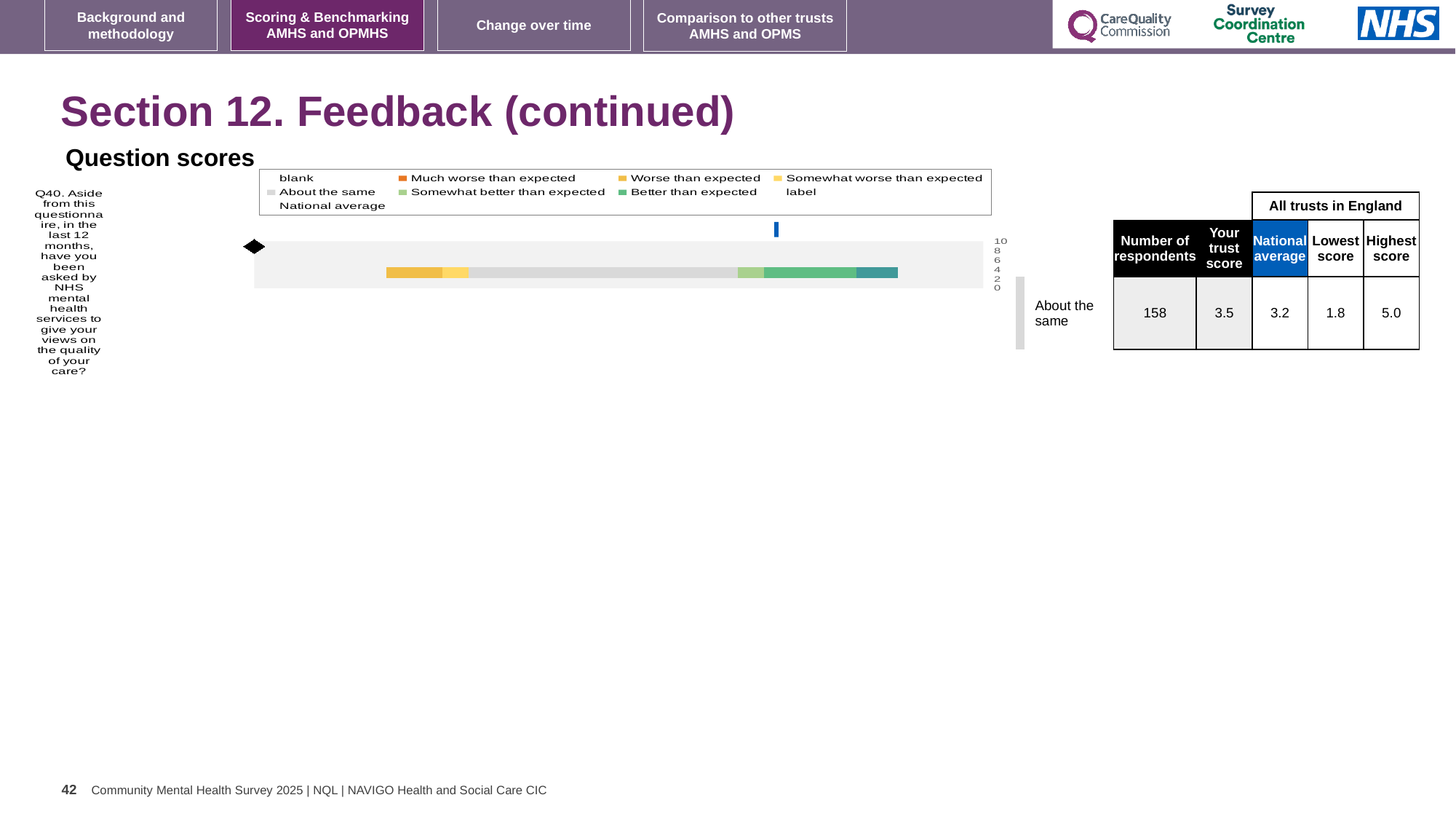
What kind of chart is used to show the Q40 question score? bar chart How many entries does the legend of the Question scores chart list? 9 What is the lowest score among all trusts in England for Q40? 1.8 What is the trust's score for Q40 shown next to the chart? 3.5 What is the national average score for Q40? 3.2 What is the highest score among all trusts in England for Q40? 5.0 What is the difference between the highest and lowest scores for Q40 across all trusts in England? 3.2 Which benchmark category is the trust's Q40 result placed in? About the same By how much does the trust's score for Q40 exceed the national average? 0.3 How many questions are plotted in the Question scores chart? 1 Which is larger for Q40, the trust's score or the national average? the trust's score How many respondents answered Q40? 158